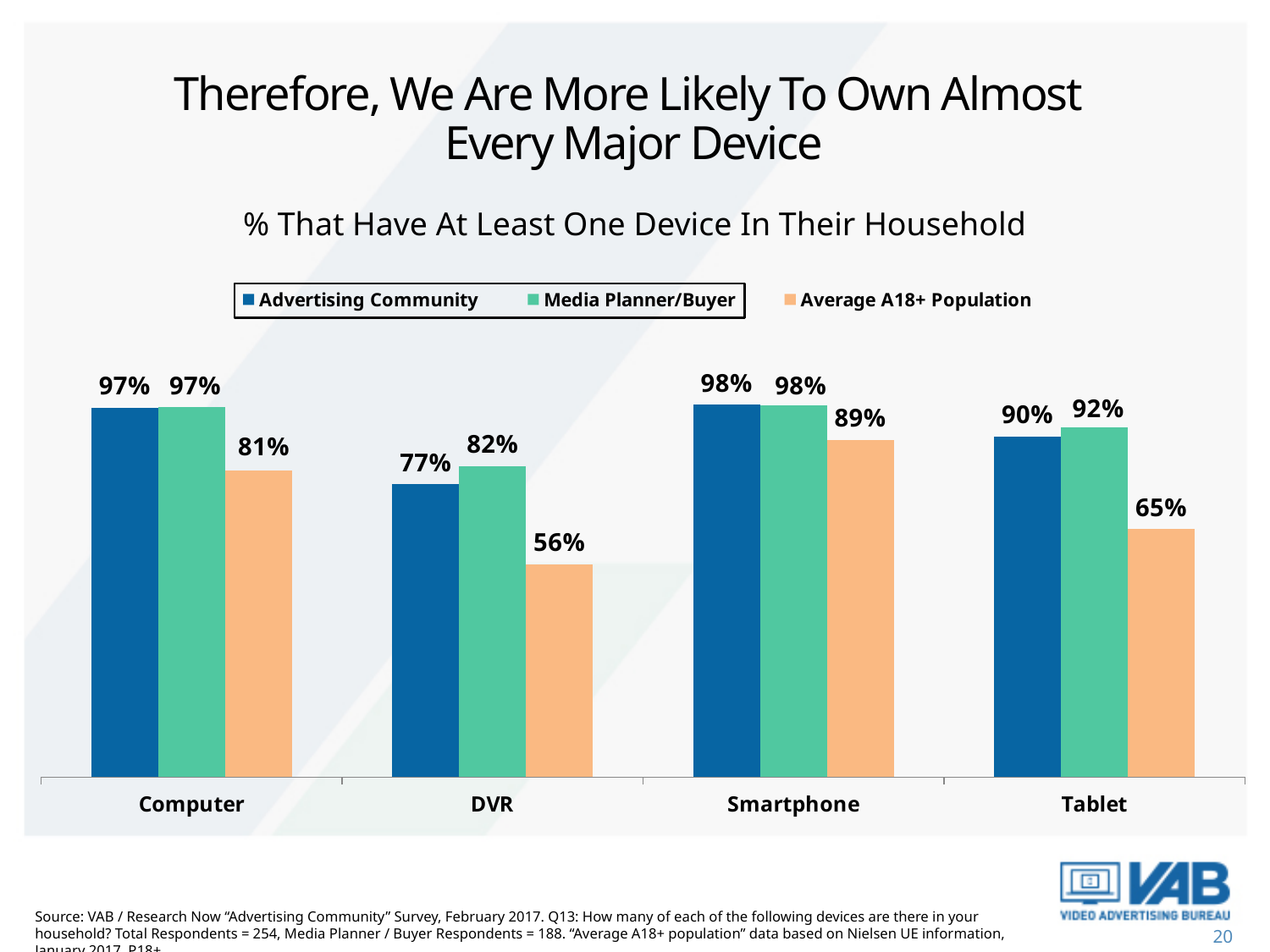
What kind of chart is shown on the slide? Bar chart How many device categories are shown on the x axis? 4 What is the subtitle of the chart? % That Have At Least One Device In Their Household Which device has the lowest value for the Average A18+ Population? DVR What percentage of the Advertising Community has at least one DVR in their household? 77% What is the difference between the Advertising Community and Average A18+ Population values for DVR? 21% What is the Media Planner/Buyer value for Smartphone? 98% For Tablet, which is larger: the Advertising Community value or the Media Planner/Buyer value? Media Planner/Buyer Which device has the highest value for the Advertising Community? Smartphone What is the difference between the Media Planner/Buyer and Average A18+ Population values for Tablet? 27% What is the Average A18+ Population value for Tablet? 65% How many series does the legend list? 3